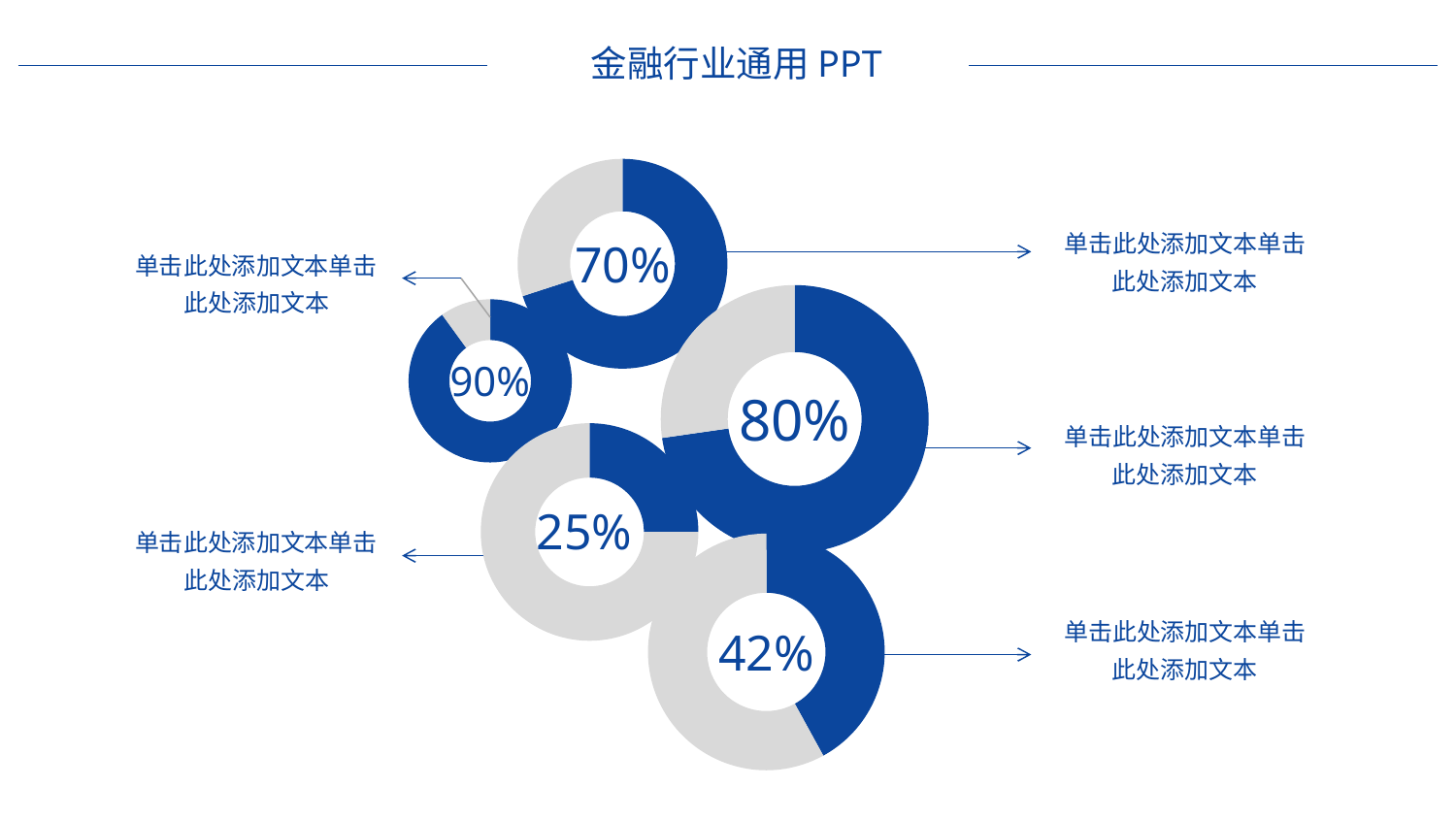
What value is printed in the centre of the bottom-right donut chart? 42% What value is printed in the centre of the largest donut chart in the middle of the slide? 80% What kind of chart is used for each of the five figures on the slide? Donut chart What is the difference between the percentages in the smallest donut chart (90%) and the bottom-left donut chart (25%)? 65% What value is printed in the centre of the topmost donut chart? 70% Which is larger, the percentage in the topmost donut chart or the percentage in the bottom-left donut chart? The topmost donut chart (70%) What is the difference between the percentage in the largest donut chart (80%) and the bottom-right donut chart (42%)? 38% Which donut chart shows the highest percentage? 90% What colour is used for the filled portion of each donut chart? Blue What value is printed in the centre of the smallest donut chart on the left? 90% Which donut chart shows the lowest percentage? 25% How many donut charts are shown on the slide? 5